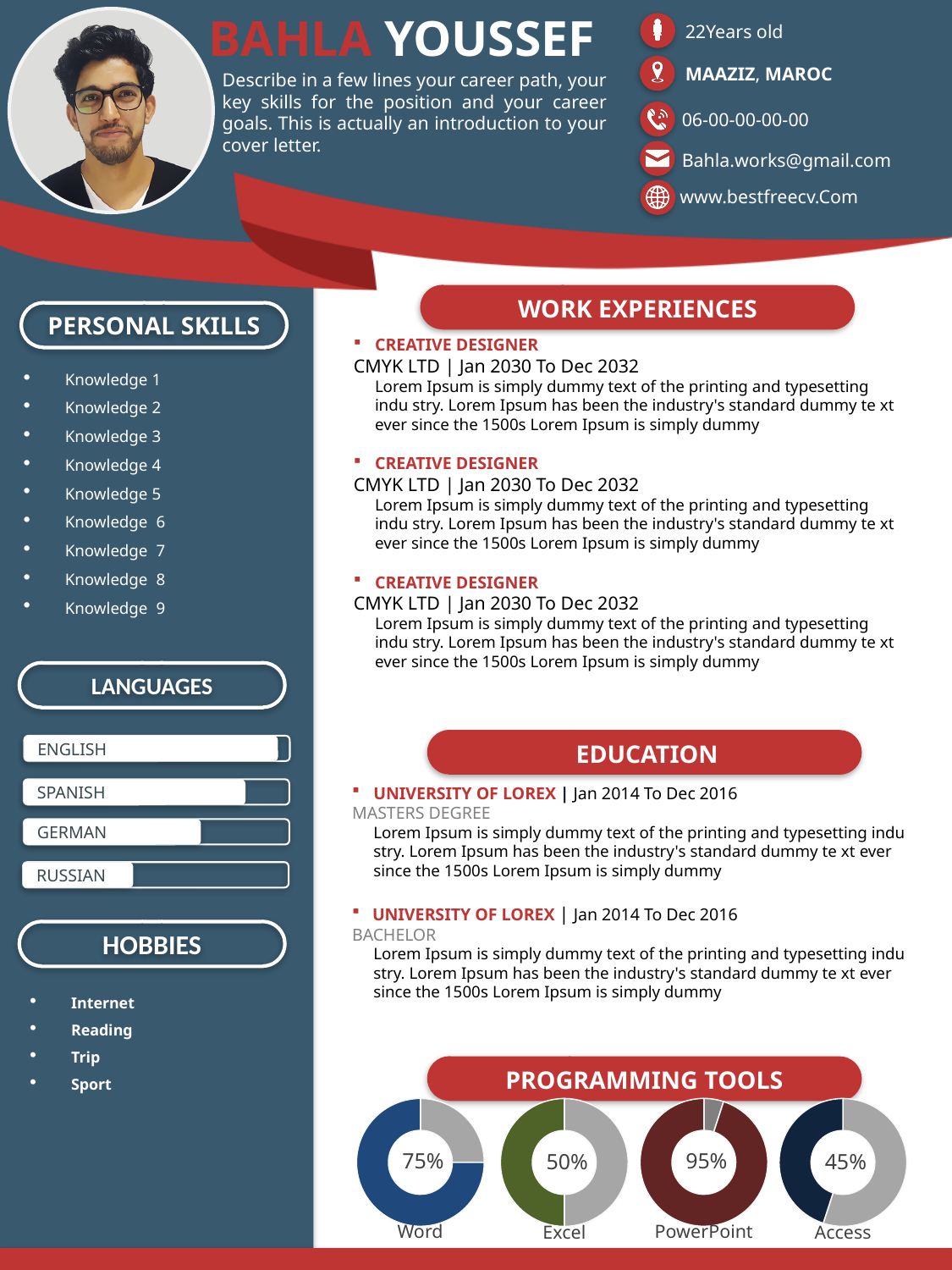
What is the title of the section containing the donut charts? PROGRAMMING TOOLS In the Programming Tools section, what percentage is shown for Word? 75% What kind of chart is used to show each programming tool's percentage? Donut chart Among the Programming Tools donut charts, which tool has the lowest percentage? Access In the Programming Tools section, what percentage is shown for Access? 45% In the Programming Tools section, what percentage is shown for PowerPoint? 95% In the Programming Tools section, what is the difference between the Excel and Access percentages? 5% In the Programming Tools section, what percentage is shown for Excel? 50% How many donut charts are shown in the Programming Tools section? 4 In the Programming Tools section, which has a larger percentage, Word or Excel? Word Among the Programming Tools donut charts, which tool has the highest percentage? PowerPoint In the Programming Tools section, what is the difference between the PowerPoint and Word percentages? 20%